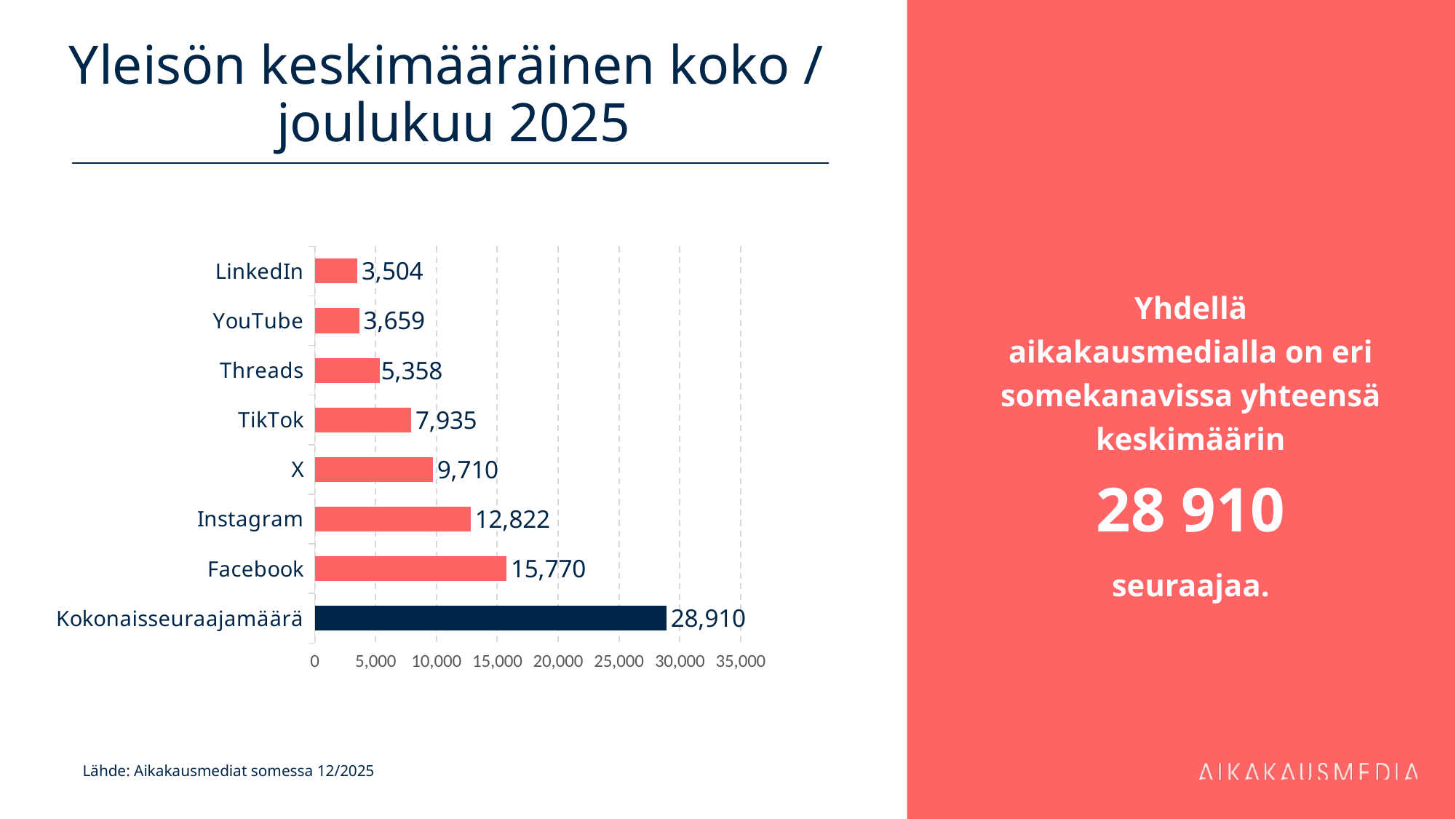
What is the value for Kokonaisseuraajamäärä? 28,910 Which category has the highest value? Kokonaisseuraajamäärä How many categories are shown in the chart? 8 Is the value for Instagram greater or less than 10,000? greater What is the difference between the values for YouTube and LinkedIn? 155 Which category has the lowest value? LinkedIn What colour is the bar for Kokonaisseuraajamäärä? dark navy blue What is the value for Facebook? 15,770 What kind of chart is shown on the slide? bar chart What is the difference between the values for Facebook and Instagram? 2,948 What is the value for TikTok? 7,935 Which is larger, the value for X or the value for Threads? X